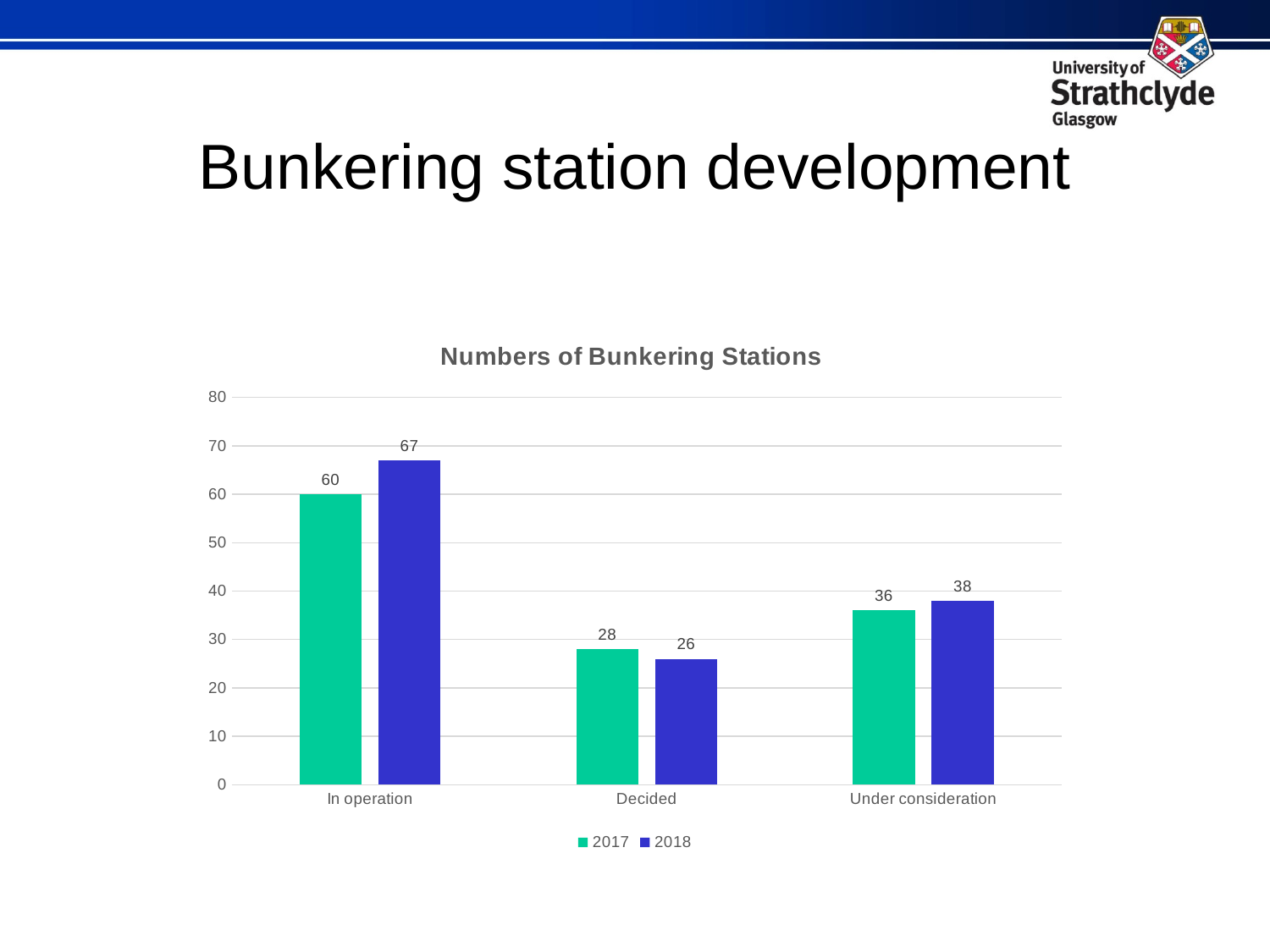
What is the difference between the 2018 and 2017 values for In operation? 7 Which category has the highest 2018 value? In operation What kind of chart is shown? bar chart What is the title of the chart? Numbers of Bunkering Stations What is the 2018 value for Under consideration? 38 Which category has the lowest 2017 value? Decided What is the 2017 value for In operation? 60 How many series does the legend list? 2 What is the 2018 value for Decided? 26 Which is larger for Decided, the 2017 value or the 2018 value? 2017 How many categories are shown on the x axis? 3 Is the 2017 value for Under consideration greater or less than 40? less